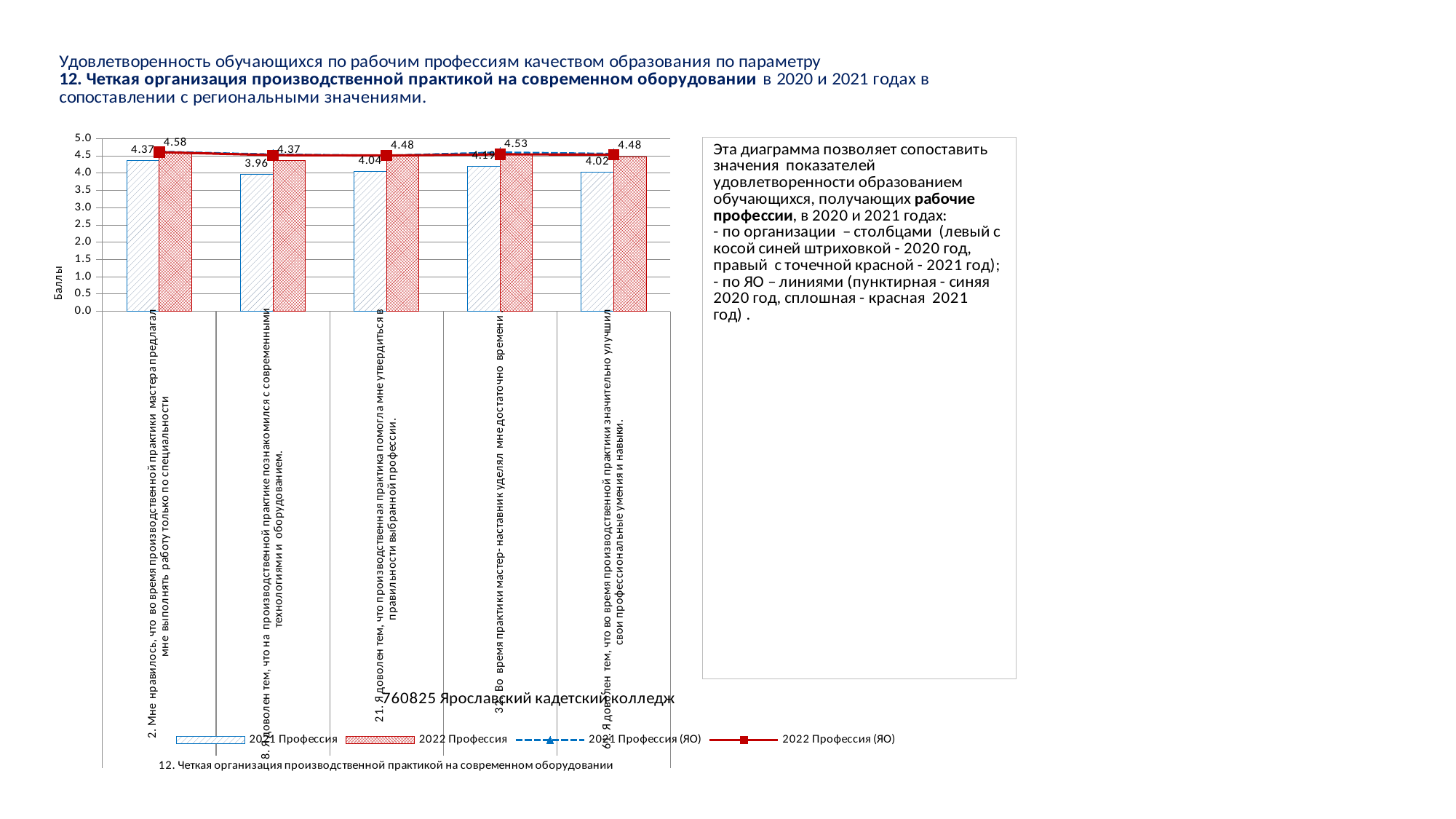
What is the title of the vertical axis of the chart? Баллы How many series does the chart legend list? 4 What is the 2022 Профессия value for the category "2. Мне нравилось, что во время производственной практики мастера предлагал мне выполнять работу только по специальности"? 4.58 For the category "21. Я доволен тем, что производственная практика помогла мне утвердиться в правильности выбранной профессии", which is larger: the 2021 Профессия value or the 2022 Профессия value? 2022 Профессия What is the 2021 Профессия value for the category "8. Я доволен тем, что на производственной практике познакомился с современными технологиями и оборудованием"? 3.96 Is the 2021 Профессия value for the category "8. Я доволен тем, что на производственной практике познакомился с современными технологиями и оборудованием" greater or less than 4.0? less Which category has the lowest 2021 Профессия value? 8. Я доволен тем, что на производственной практике познакомился с современными технологиями и оборудованием What is the 2022 Профессия value for the category "21. Я доволен тем, что производственная практика помогла мне утвердиться в правильности выбранной профессии"? 4.48 Which category has the highest 2022 Профессия value? 2. Мне нравилось, что во время производственной практики мастера предлагал мне выполнять работу только по специальности What is the difference between the 2022 Профессия and 2021 Профессия values for the category "8. Я доволен тем, что на производственной практике познакомился с современными технологиями и оборудованием"? 0.41 What kind of chart is shown on the slide? Bar chart with line series How many categories are shown on the x axis of the chart? 5